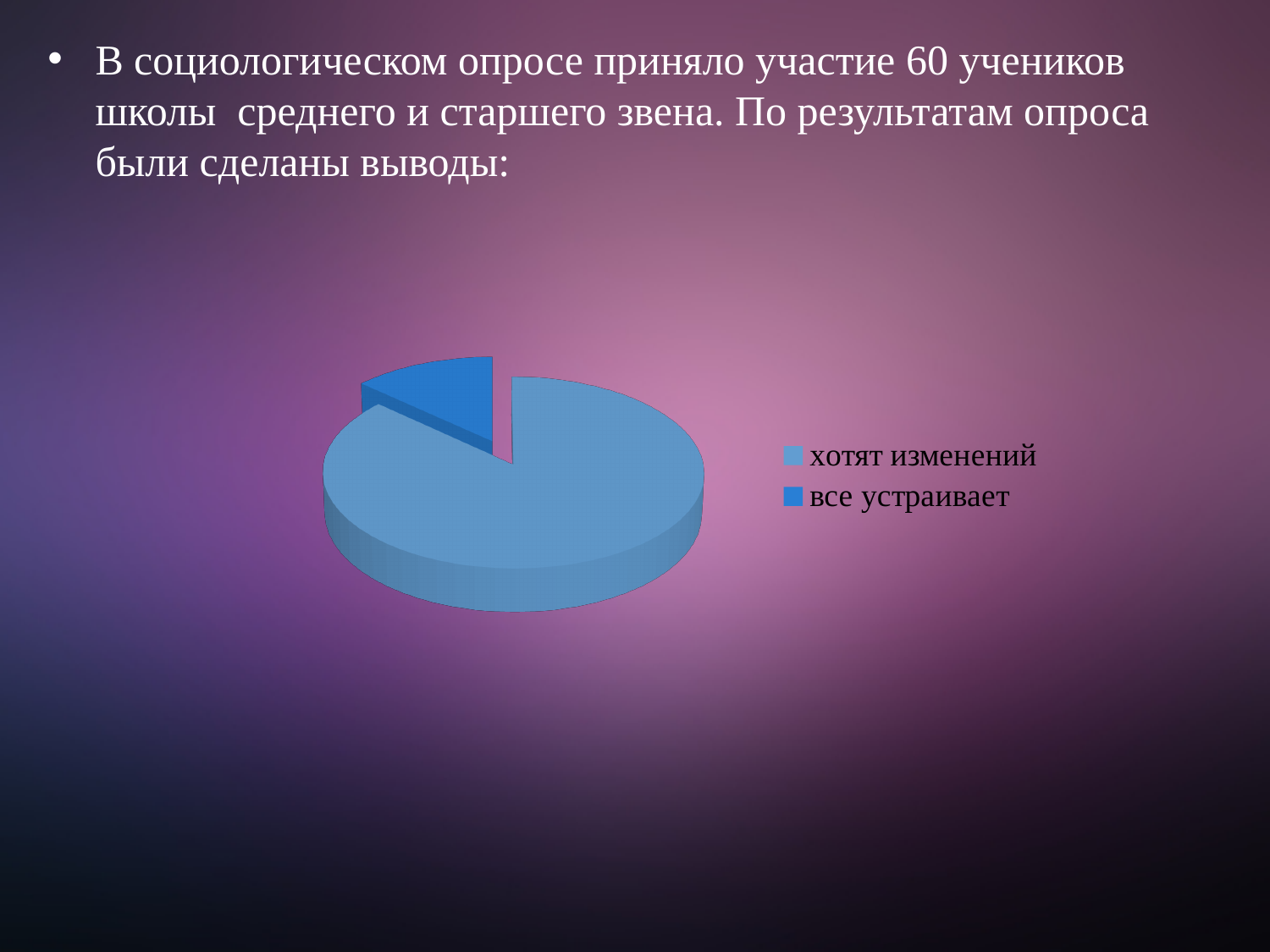
Which slice is larger: "хотят изменений" or "все устраивает"? хотят изменений What colour is the slice for "все устраивает" in the pie chart? dark blue What kind of chart is shown on the slide? pie chart What are the two legend entries of the pie chart? хотят изменений, все устраивает How many slices does the pie chart have? 2 How many entries does the legend of the pie chart list? 2 Which category has the smallest slice in the pie chart? все устраивает Which category has the largest slice in the pie chart? хотят изменений